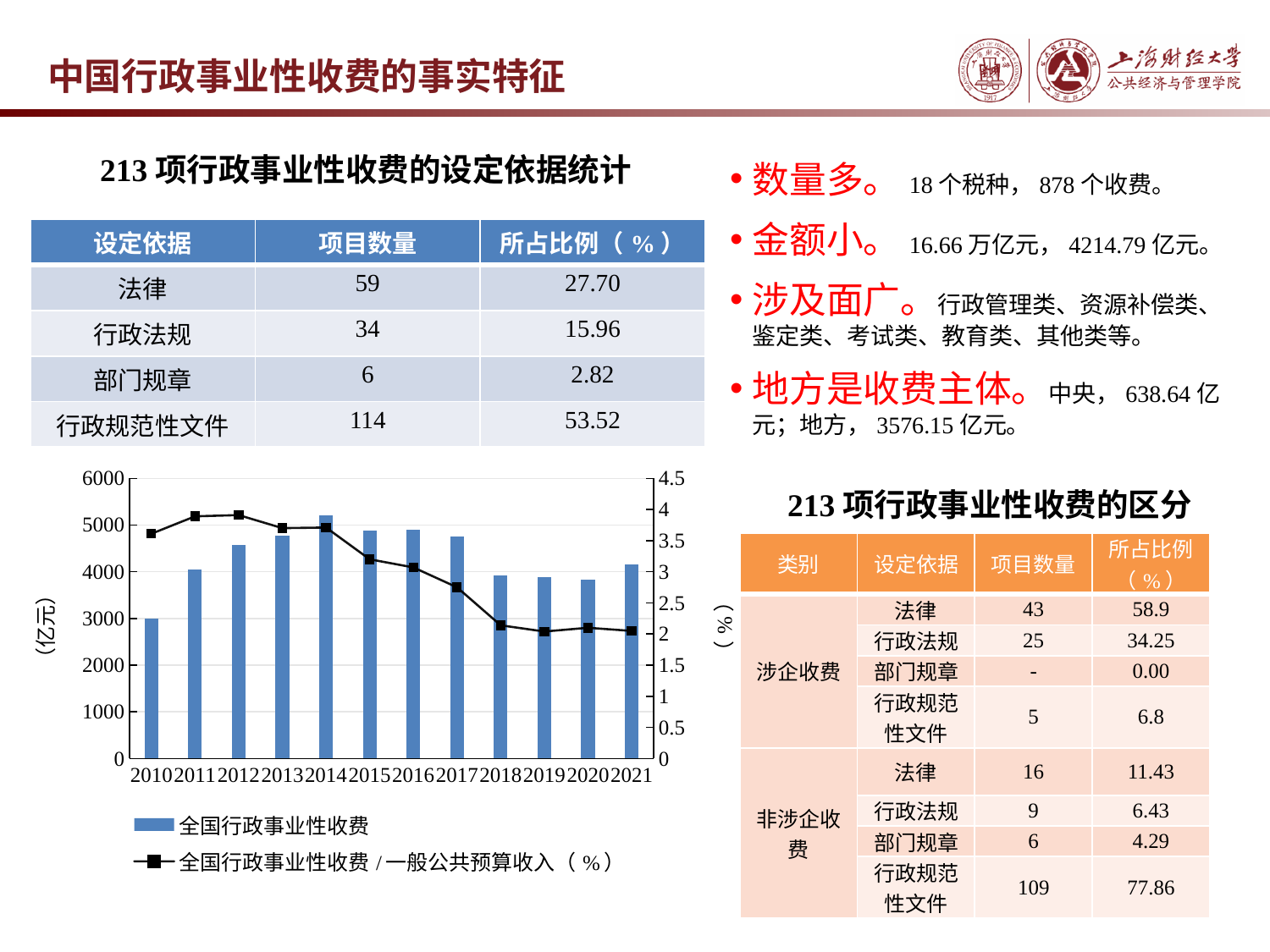
In which year is the bar for 全国行政事业性收费 the highest? 2014 Which year has the larger bar for 全国行政事业性收费, 2011 or 2012? 2012 Is the value of 全国行政事业性收费 / 一般公共预算收入 (%) for 2021 greater or less than 3? less How many series does the chart legend list? 2 Is the value of 全国行政事业性收费 for 2010 greater or less than 4000? less Does the line for 全国行政事业性收费 / 一般公共预算收入 (%) generally rise or fall from 2010 to 2021? fall In which year is the bar for 全国行政事业性收费 the lowest? 2010 What kind of chart is shown on the slide? A combined bar and line chart Is the value of 全国行政事业性收费 / 一般公共预算收入 (%) for 2010 greater or less than 3? greater What unit is shown on the left vertical axis of the chart? 亿元 How many years are plotted along the x axis of the chart? 12